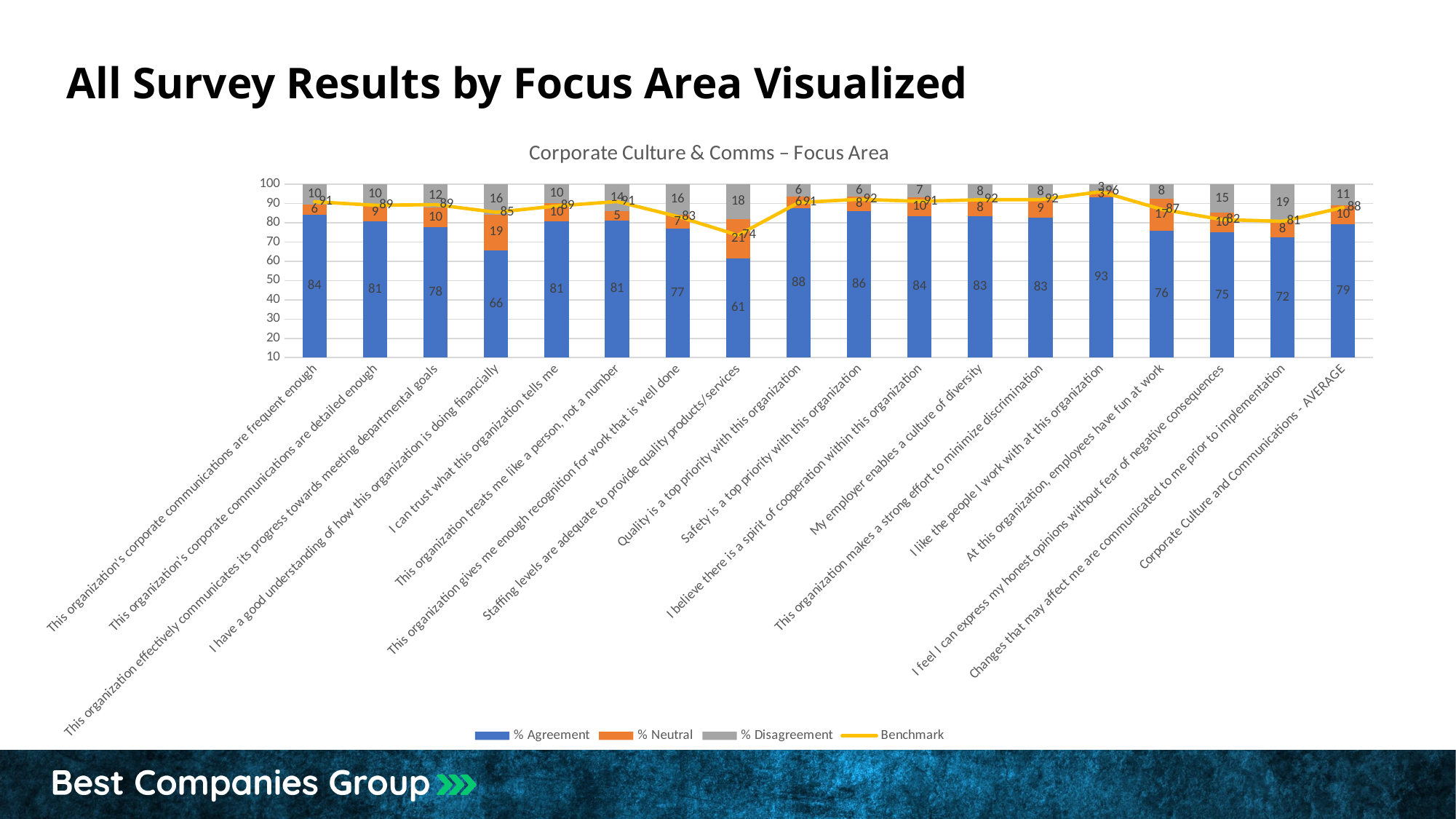
Which has a higher % Agreement: "Quality is a top priority with this organization" or "Safety is a top priority with this organization"? Quality is a top priority with this organization How many categories are shown on the x axis of the chart? 18 What is the total of the stacked bar for "This organization's corporate communications are frequent enough"? 100 What is the title of the chart? Corporate Culture & Comms – Focus Area Which category has the highest % Agreement value? I like the people I work with at this organization What is the % Disagreement value for "Changes that may affect me are communicated to me prior to implementation"? 19 What is the % Agreement value for "Staffing levels are adequate to provide quality products/services"? 61 What is the Benchmark value for "I have a good understanding of how this organization is doing financially"? 85 Which category has the lowest % Agreement value? Staffing levels are adequate to provide quality products/services How many series does the legend list? 4 What is the % Neutral value for "At this organization, employees have fun at work"? 17 What is the difference between the Benchmark and the % Agreement for "Corporate Culture and Communications - AVERAGE"? 9